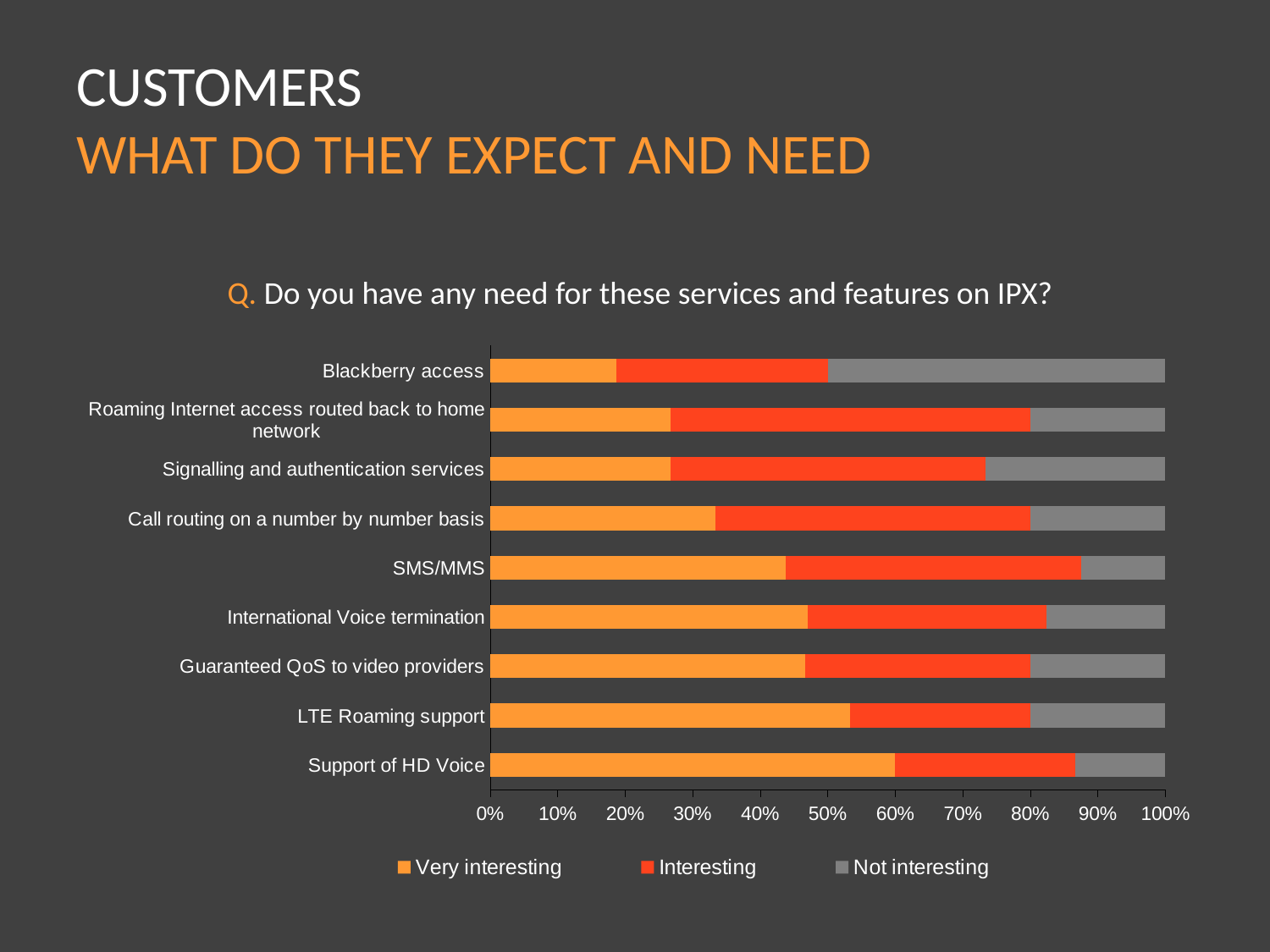
Is the 'Very interesting' value for SMS/MMS greater or less than 30%? greater What are the three legend entries of the chart? Very interesting, Interesting, Not interesting What kind of chart is shown on the slide? Stacked bar chart Which has the larger 'Very interesting' share: Call routing on a number by number basis or Roaming Internet access routed back to home network? Call routing on a number by number basis Is the 'Very interesting' value for Support of HD Voice greater or less than 50%? greater Which service has the largest 'Very interesting' share? Support of HD Voice How many series does the legend list? 3 Is the 'Very interesting' value for Blackberry access greater or less than 30%? less Which service has the largest 'Not interesting' share? Blackberry access How many services or features are listed on the chart? 9 Which has the larger 'Not interesting' share: Blackberry access or SMS/MMS? Blackberry access Which service has the smallest 'Very interesting' share? Blackberry access